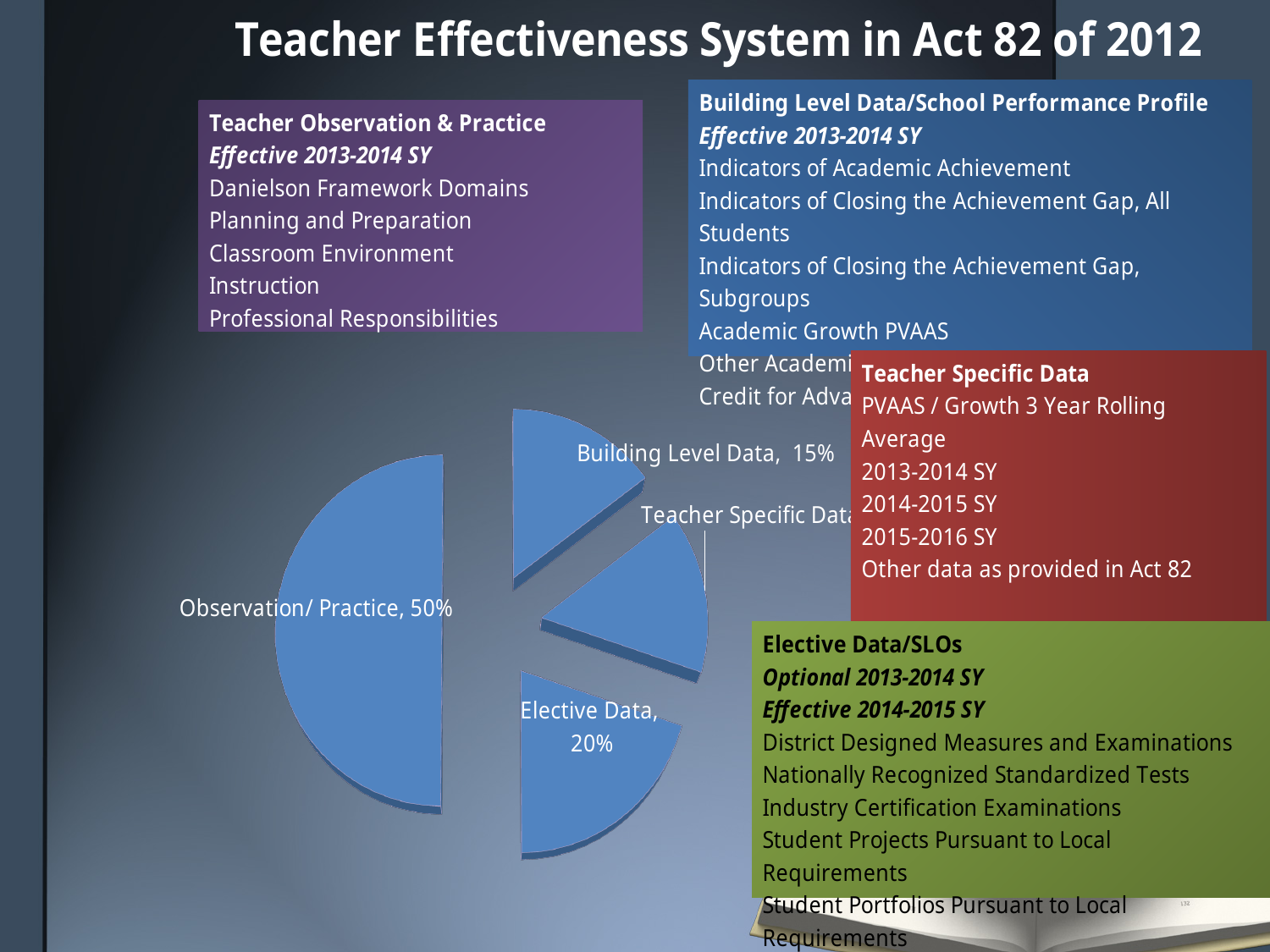
What share of the pie does Observation/ Practice represent? 50% What share of the pie does Elective Data represent? 20% Which slice of the pie chart is labelled but has its percentage hidden by an overlapping text box? Teacher Specific Data What colour are the slices of the pie chart? blue What type of chart is shown on the slide? pie chart How many slices does the pie chart have? 4 What share of the pie does Building Level Data represent? 15% What is the difference in percentage points between Elective Data and Building Level Data? 5 What is the difference in percentage points between Observation/ Practice and Building Level Data? 35 Which is larger in the pie chart, Elective Data or Building Level Data? Elective Data What is the difference in percentage points between Observation/ Practice and Elective Data? 30 Which slice of the pie chart is the largest? Observation/ Practice